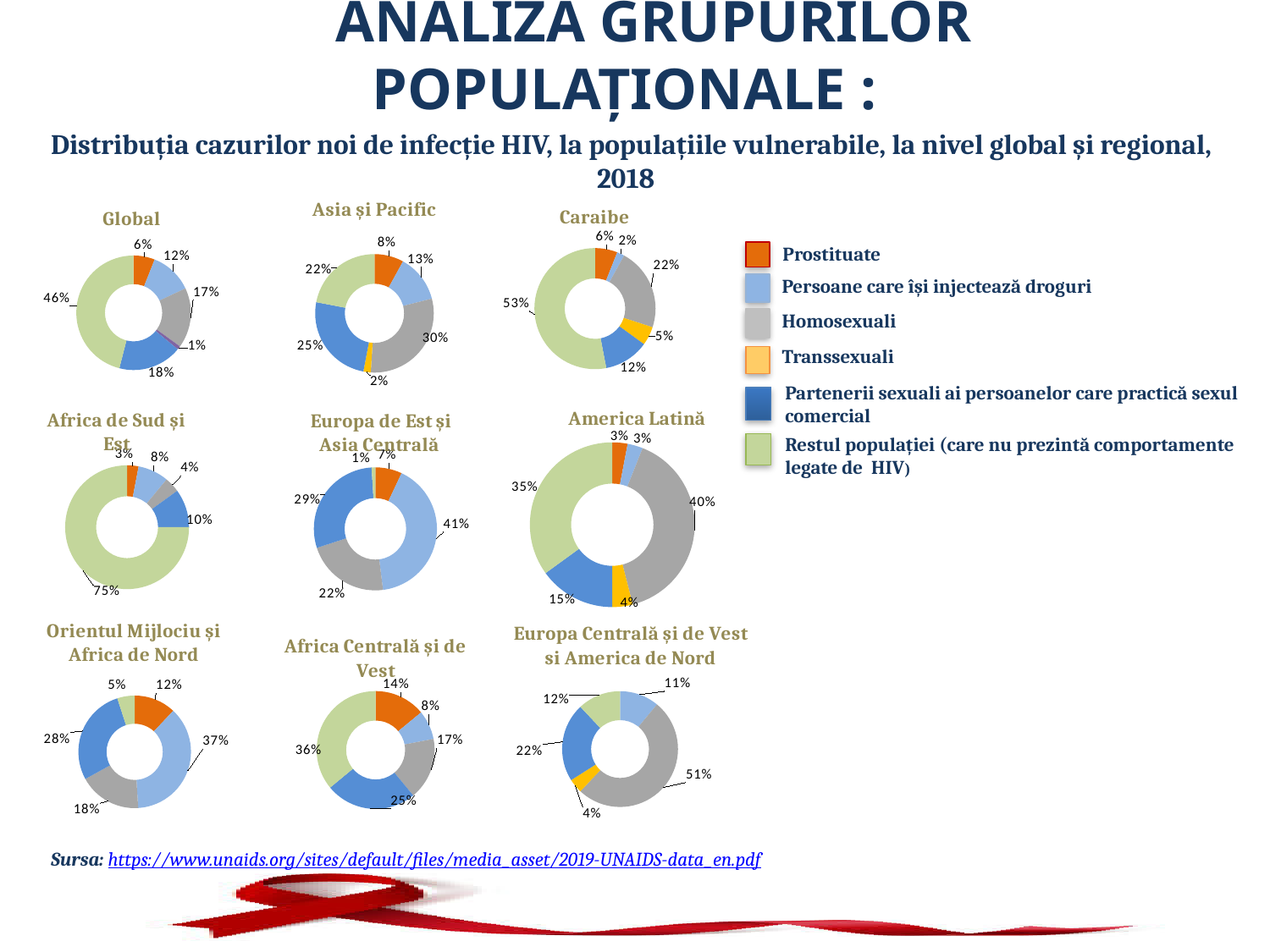
In the Europa Centrală și de Vest si America de Nord chart, what is the share for 'Homosexuali'? 51% In the Africa Centrală și de Vest chart, which is larger: the share for 'Prostituate' or the share for 'Homosexuali'? Homosexuali In the Global chart, what share of new HIV infections is attributed to 'Restul populației'? 46% How many entries does the legend list? 6 In the Africa de Sud și Est chart, what is the share for 'Restul populației'? 75% In the Orientul Mijlociu și Africa de Nord chart, what is the difference between the share for 'Persoane care își injectează droguri' and the share for 'Homosexuali'? 19% In the Europa de Est și Asia Centrală chart, what is the share for 'Persoane care își injectează droguri'? 41% In the Asia și Pacific chart, what is the share for 'Homosexuali'? 30% In the America Latină chart, which group has the largest share? Homosexuali What kind of chart is used for each region on the slide? Donut (pie) chart In the Caraibe chart, which group has the largest share? Restul populației How many regional/global donut charts are shown on the slide? 9